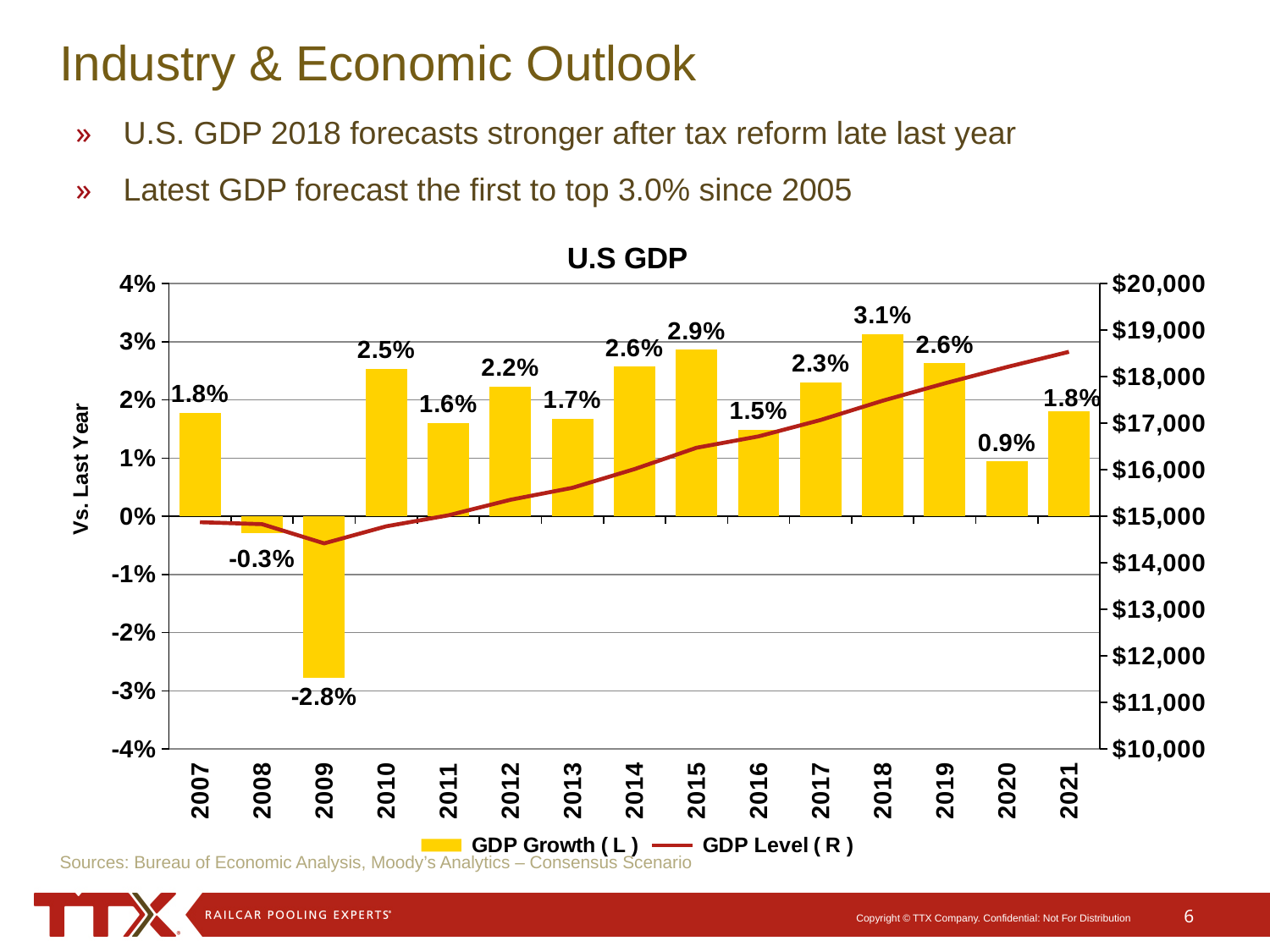
In the U.S GDP chart, what is the GDP Growth value for 2018? 3.1% In the U.S GDP chart, which year has higher GDP Growth, 2014 or 2015? 2015 How many series does the legend of the U.S GDP chart list? 2 In the U.S GDP chart, what is the difference between the GDP Growth values for 2018 and 2019? 0.5% How many years are shown on the x axis of the U.S GDP chart? 15 In the U.S GDP chart, is the GDP Level for 2021 greater or less than $18,000? greater In the U.S GDP chart, what is the GDP Growth value for 2009? -2.8% What kind of chart is the U.S GDP chart? Combined bar and line chart In the U.S GDP chart, which year has the highest GDP Growth? 2018 In the U.S GDP chart, what is the GDP Growth value for 2020? 0.9% In the U.S GDP chart, which year has the lowest GDP Growth? 2009 In the U.S GDP chart, is the GDP Level for 2009 greater or less than $15,000? less